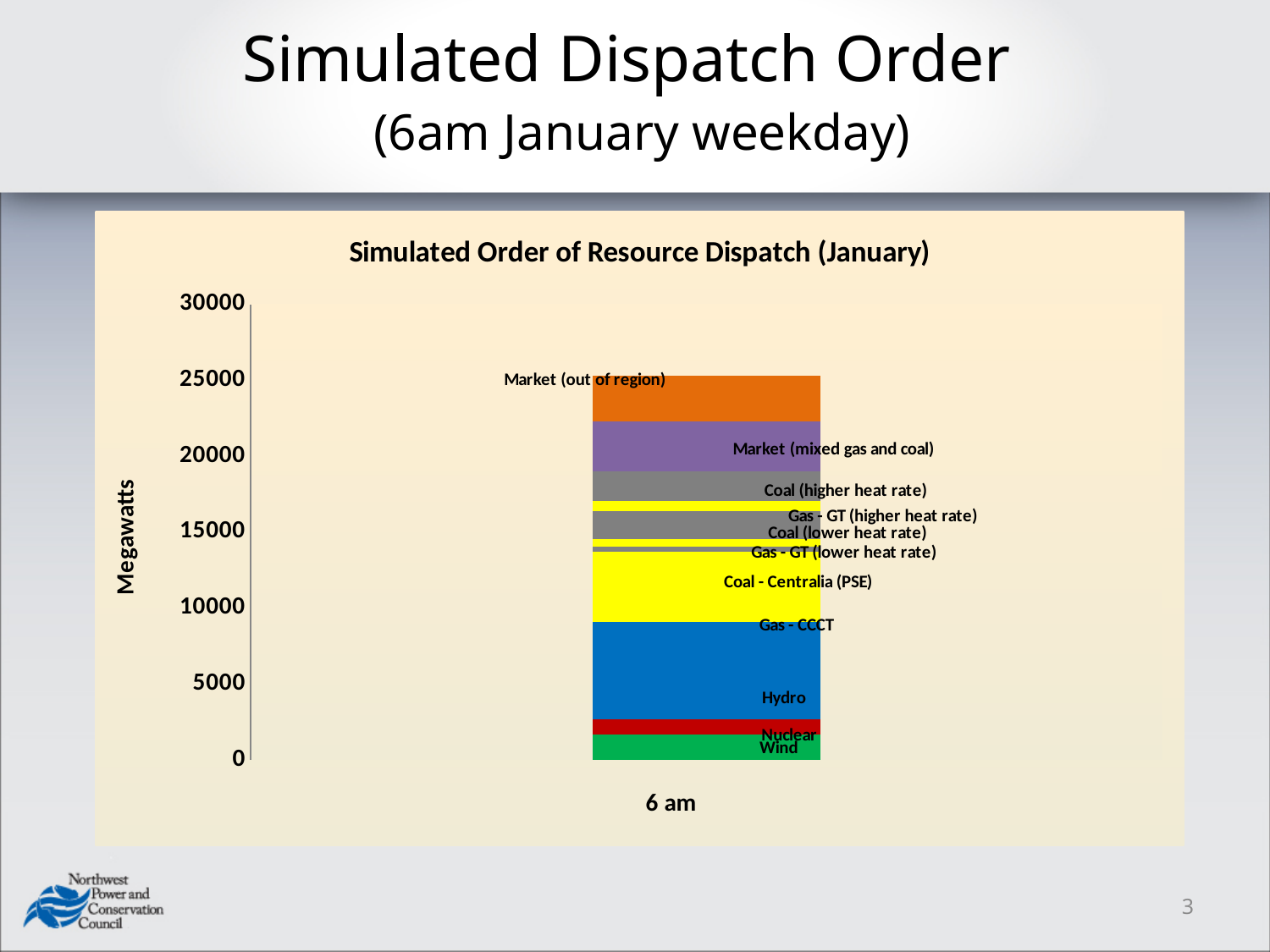
What is the title of the chart? Simulated Order of Resource Dispatch (January) How many categories (bars) are plotted on the x axis? 1 Which segment is larger, Hydro or Nuclear? Hydro Which resource segment is the largest in the stacked bar? Hydro Is the total height of the stacked bar greater or less than 20000? greater Which resource segment is at the top of the stacked bar? Market (out of region) What kind of chart is shown on the slide? Stacked bar chart How many resource segments make up the stacked bar? 11 What is the label on the vertical axis of the chart? Megawatts What is the category label shown under the bar? 6 am Which resource segment is at the bottom of the stacked bar? Wind